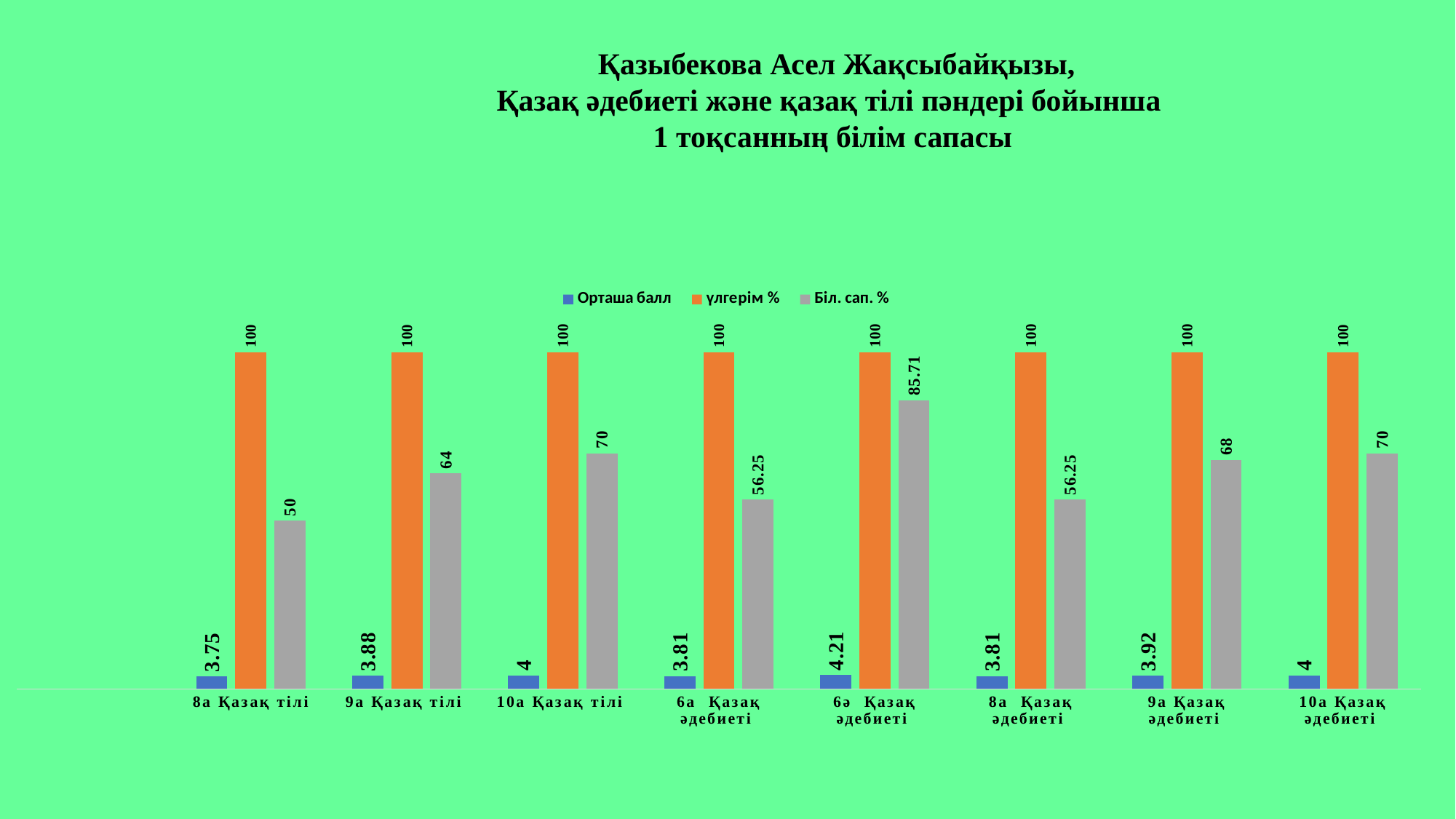
How many series does the legend list? 3 What kind of chart is shown on the slide? bar chart What is the үлгерім % value for 9а Қазақ тілі? 100 What is the Біл. сап. % value for 6ә Қазақ әдебиеті? 85.71 Which is larger, the Біл. сап. % for 6а Қазақ әдебиеті or for 9а Қазақ әдебиеті? 9а Қазақ әдебиеті What is the Біл. сап. % value for 9а Қазақ әдебиеті? 68 What is the Орташа балл value for 8а Қазақ тілі? 3.75 How many categories are shown on the x axis? 8 Which series is shown in orange? үлгерім % Which category has the highest Орташа балл? 6ә Қазақ әдебиеті What is the difference between the Біл. сап. % values for 10а Қазақ тілі and 9а Қазақ тілі? 6 Which category has the lowest Біл. сап. %? 8а Қазақ тілі